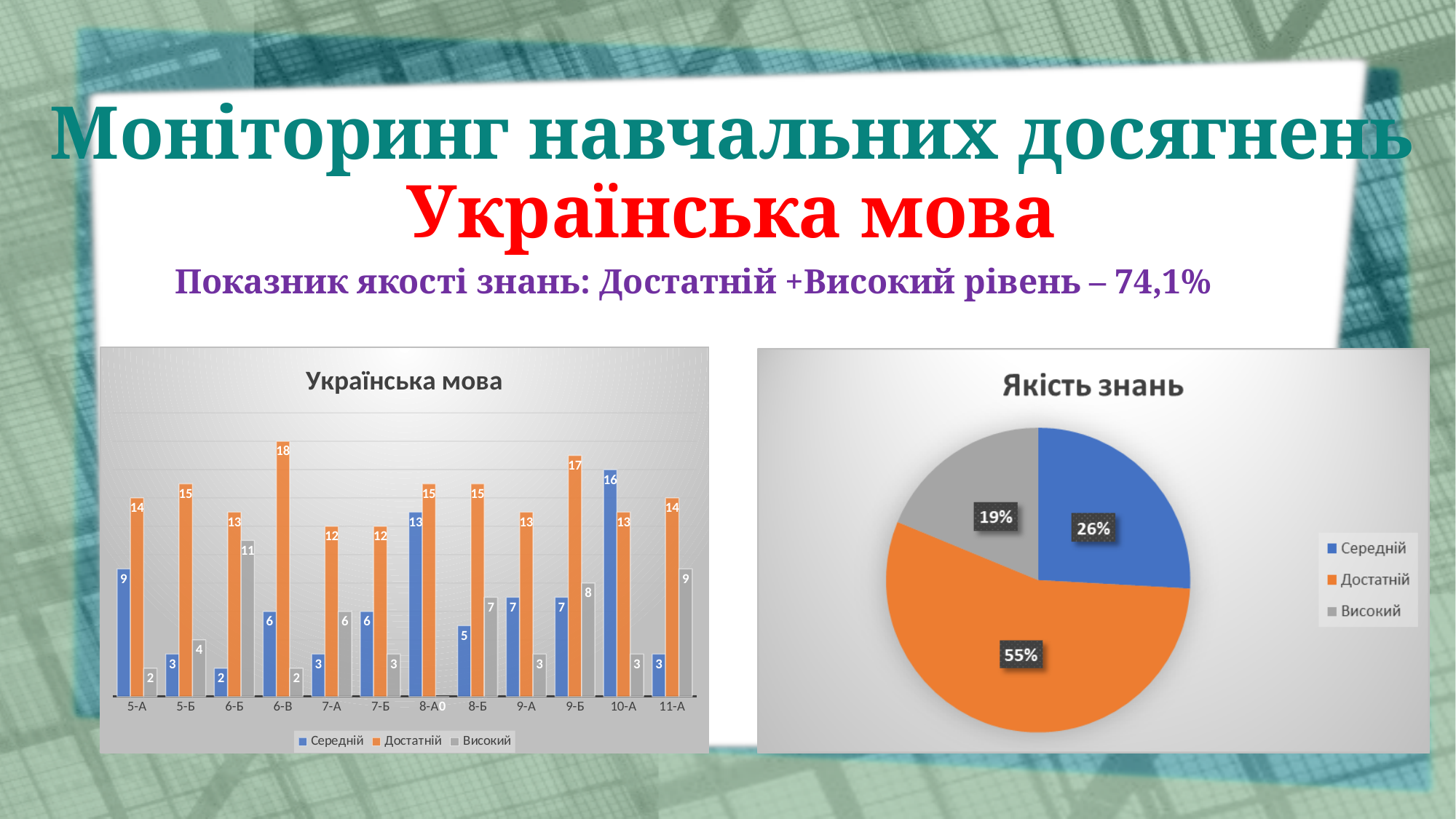
In the 'Українська мова' bar chart, which is larger for 11-А: Середній or Високий? Високий In the 'Українська мова' bar chart, what is the difference between the Достатній values for 9-Б and 7-А? 5 In the 'Українська мова' bar chart, which class has the highest Достатній value? 6-В In the 'Українська мова' bar chart, what is the Достатній value for 6-В? 18 In the 'Українська мова' bar chart, which class has the lowest Високий value? 8-А In the 'Українська мова' bar chart, what is the Середній value for 10-А? 16 In the 'Якість знань' pie chart, which slice is the smallest? Високий What type of chart is 'Якість знань'? Pie chart In the 'Українська мова' bar chart, what is the Високий value for 6-Б? 11 How many series does the legend of the 'Українська мова' bar chart list? 3 How many classes are shown on the x axis of the 'Українська мова' bar chart? 12 In the 'Якість знань' pie chart, what share does Достатній have? 55%